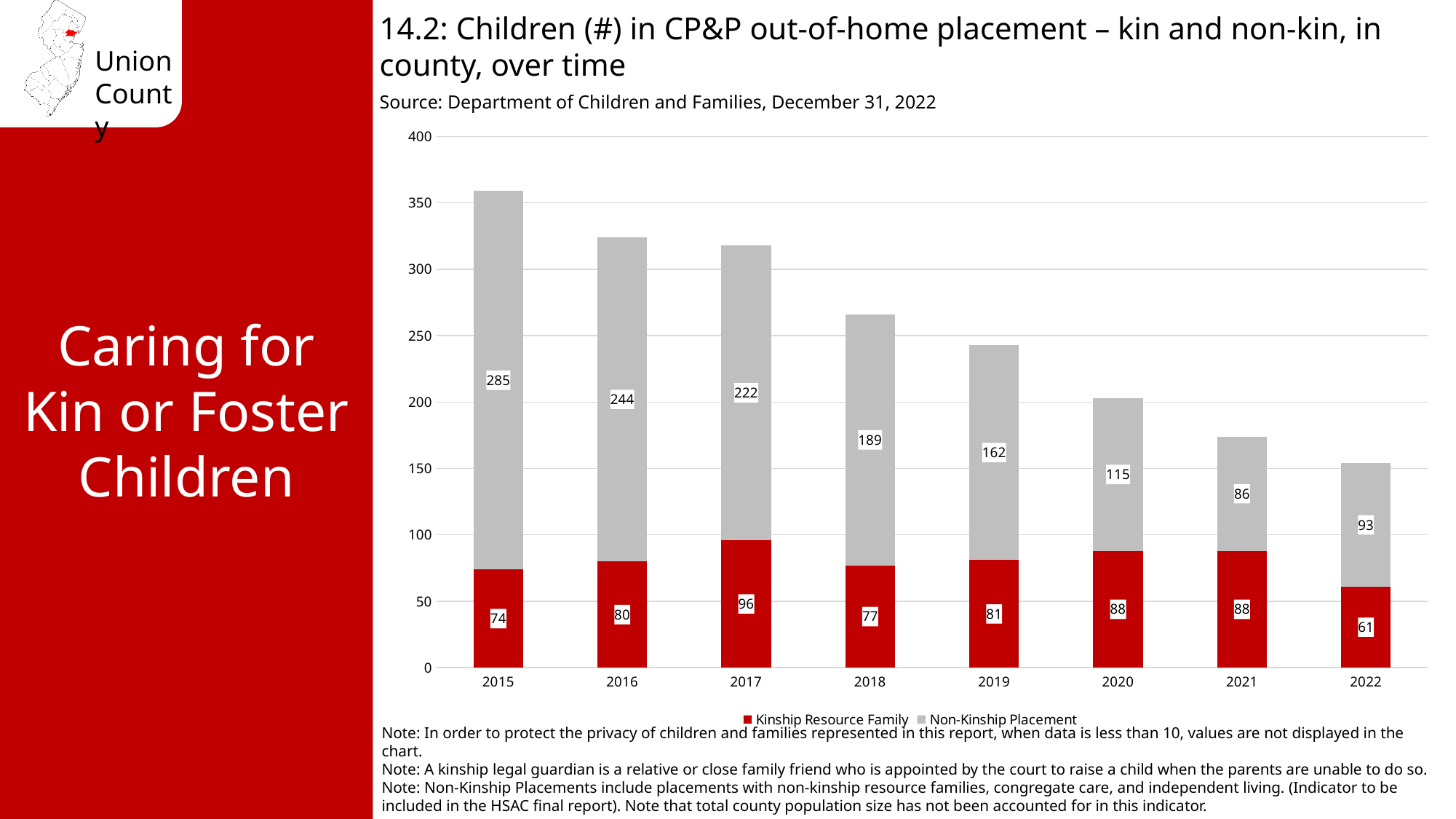
What type of chart is shown on the slide? Stacked bar chart How many series does the legend list? 2 What is the total number of children in out-of-home placement in 2020 (both series combined)? 203 What is the Kinship Resource Family value for 2017? 96 What is the Non-Kinship Placement value for 2022? 93 What is the Non-Kinship Placement value for 2015? 285 Does the Non-Kinship Placement value generally rise or fall from 2015 to 2022? Fall How many years are shown on the x axis? 8 Is the Non-Kinship Placement value for 2018 larger or smaller than the Kinship Resource Family value for 2018? Larger Which year has the lowest Non-Kinship Placement value? 2021 Which year has the highest Kinship Resource Family value? 2017 What is the difference between the Non-Kinship Placement values for 2015 and 2016? 41